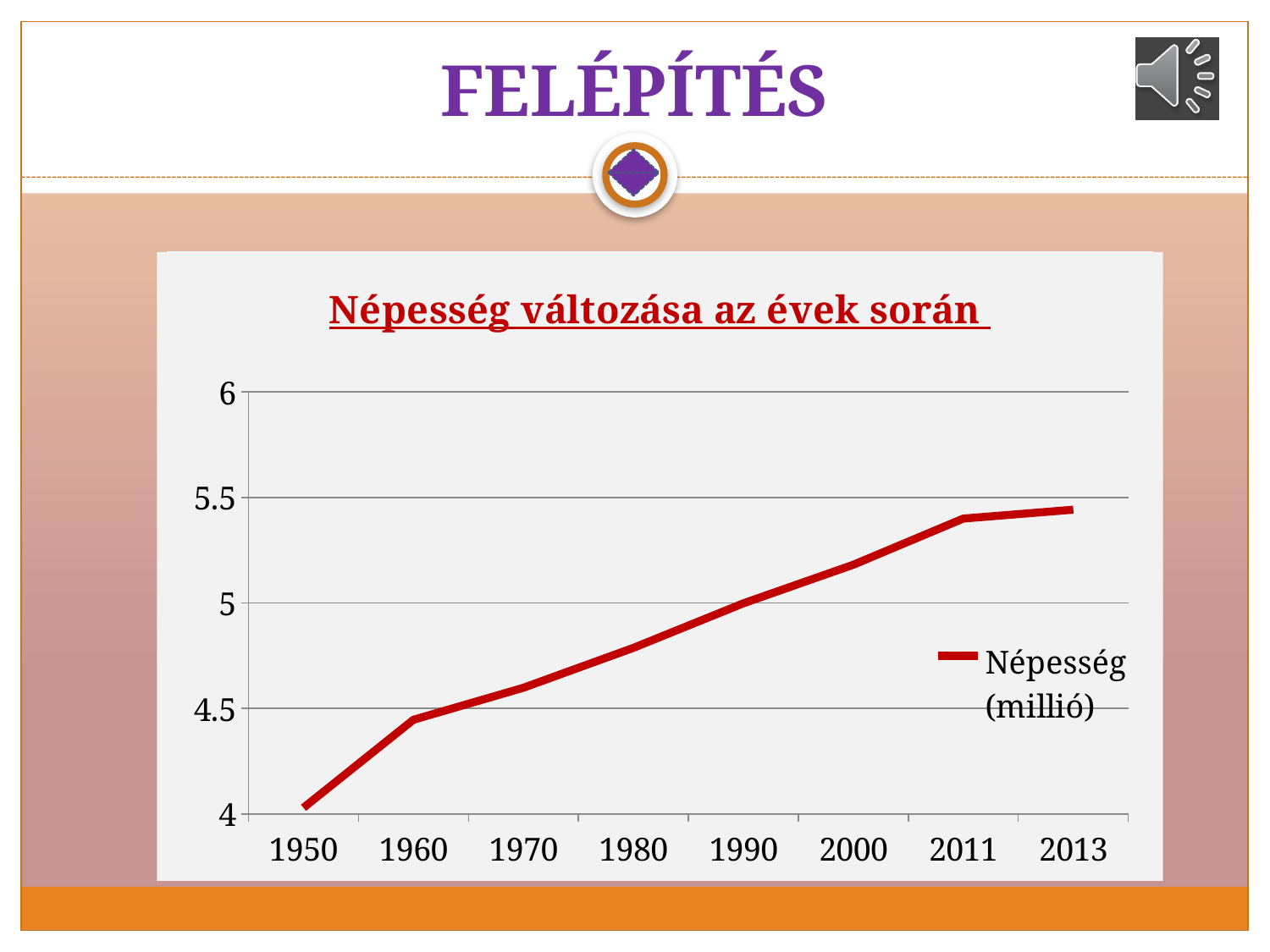
Is the value for 1950 greater or less than 4.5? less Is the value for 2000 greater or less than 5? greater Which is larger, the value for 1970 or the value for 2011? 2011 Which year has the lowest value? 1950 How many series does the legend list? 1 Is the value for 1980 greater or less than 5? less Do the values rise or fall from 1950 to 2013? rise Which year has the highest value? 2013 How many years are shown on the x axis? 8 What is the legend entry for the plotted series? Népesség (millió) What kind of chart is shown on the slide? line chart What is the title of the chart? Népesség változása az évek során